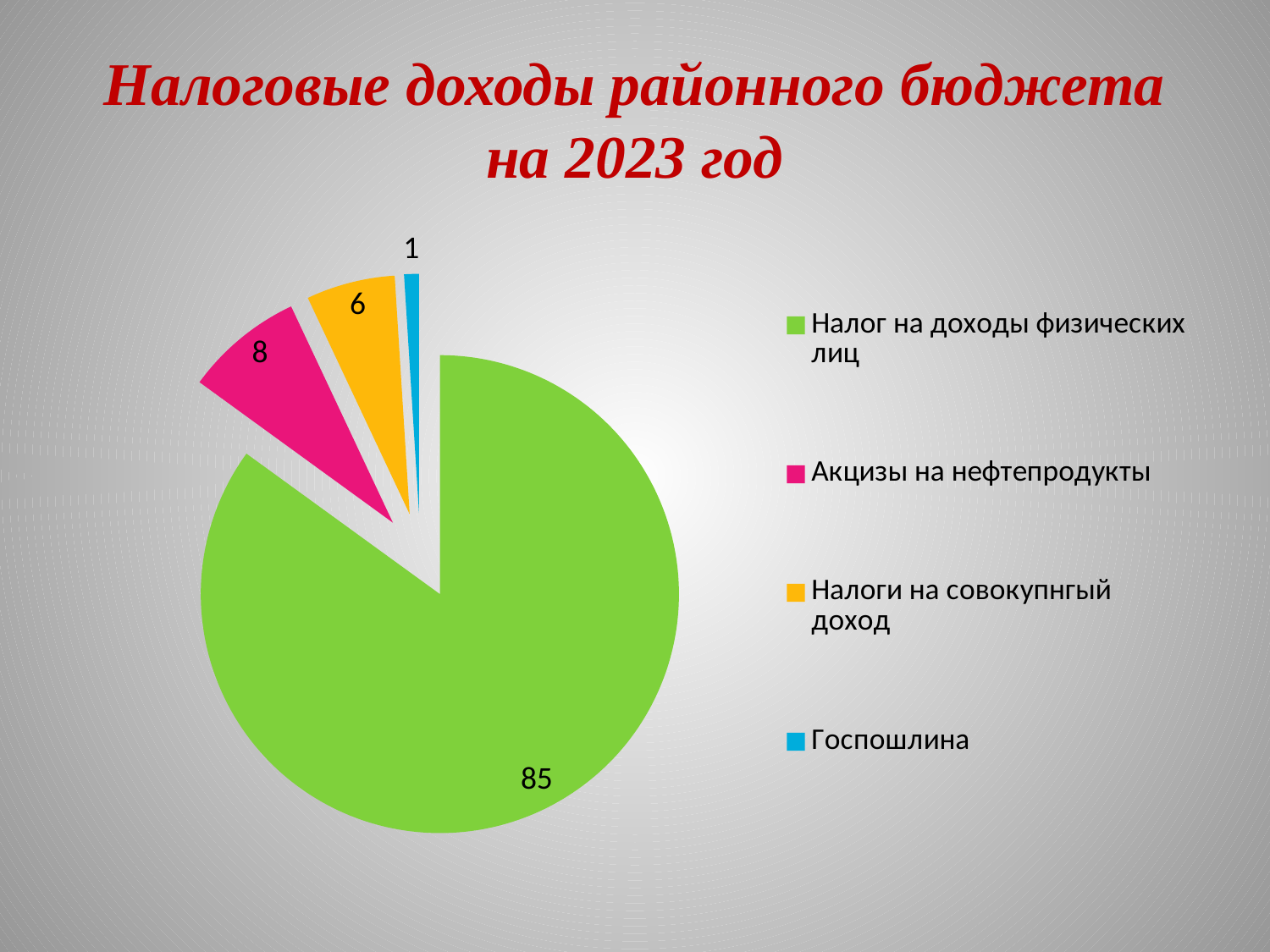
Which category has the smallest slice of the pie? Госпошлина What is the difference between the values for Акцизы на нефтепродукты and Налоги на совокупнгый доход? 2 What is the value for Налоги на совокупнгый доход? 6 Which is larger, the value for Акцизы на нефтепродукты or the value for Госпошлина? Акцизы на нефтепродукты What is the value for Налог на доходы физических лиц? 85 What is the value for Акцизы на нефтепродукты? 8 Which category has the largest slice of the pie? Налог на доходы физических лиц What type of chart is shown on the slide? pie chart What is the value for Госпошлина? 1 What is the title of the chart on the slide? Налоговые доходы районного бюджета на 2023 год What share of the pie does Налог на доходы физических лиц represent? 85% How many slices does the pie chart have? 4